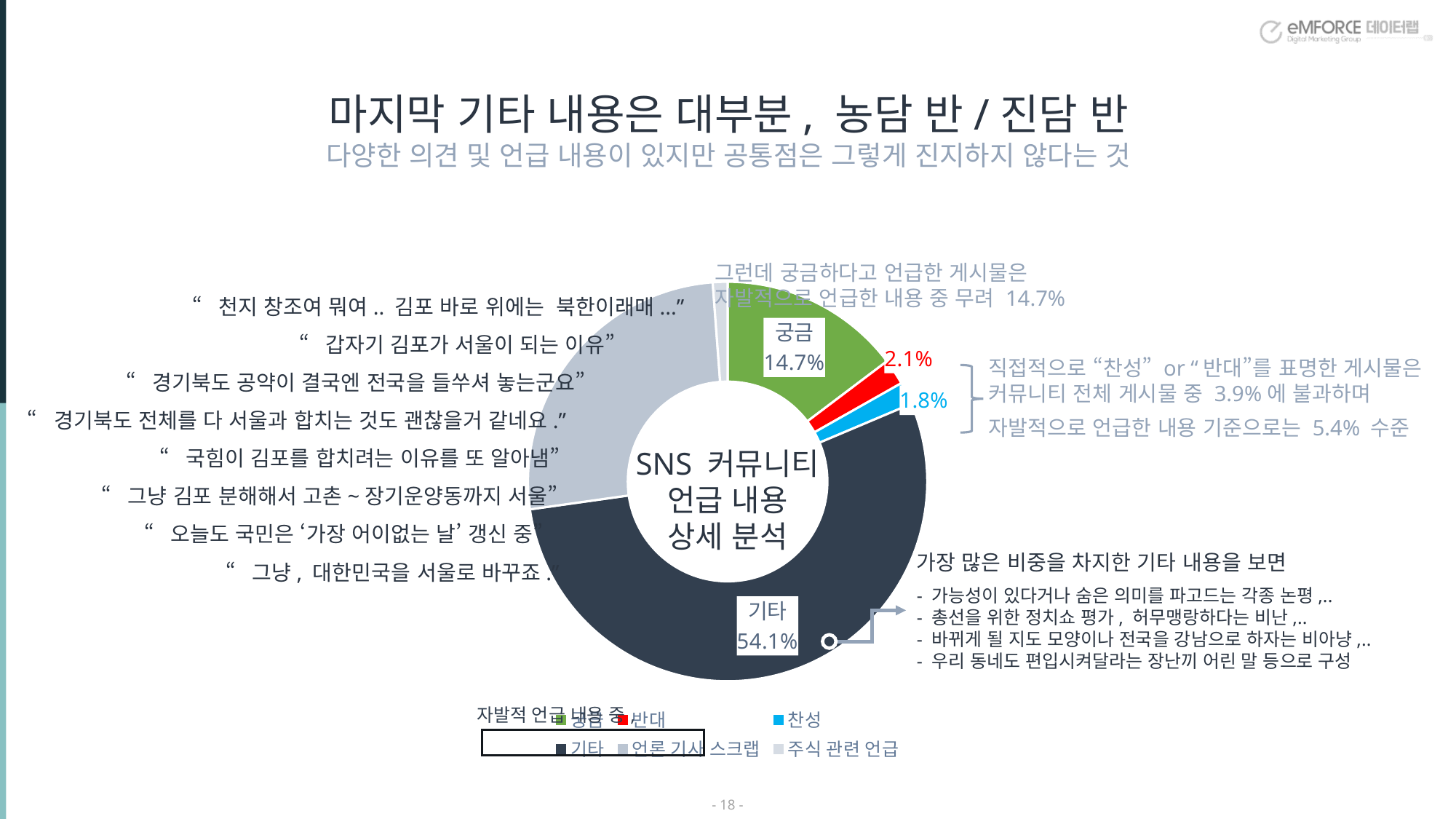
What kind of chart is shown on the slide? pie chart (donut) Which category has the largest share of the donut chart? 기타 What is the difference in percentage points between the 반대 slice and the 찬성 slice? 0.3% Which is larger, the 반대 slice or the 찬성 slice? 반대 How many categories does the legend of the donut chart list? 6 What percentage is shown for the 기타 slice? 54.1% What percentage is shown for the 찬성 slice? 1.8% What is the difference in percentage points between the 기타 slice and the 궁금 slice? 39.4% What percentage is shown for the 반대 slice? 2.1% What percentage is shown for the 궁금 slice? 14.7% What colour is the 궁금 slice in the donut chart? green What is the title shown in the centre of the donut chart? SNS 커뮤니티 언급 내용 상세 분석